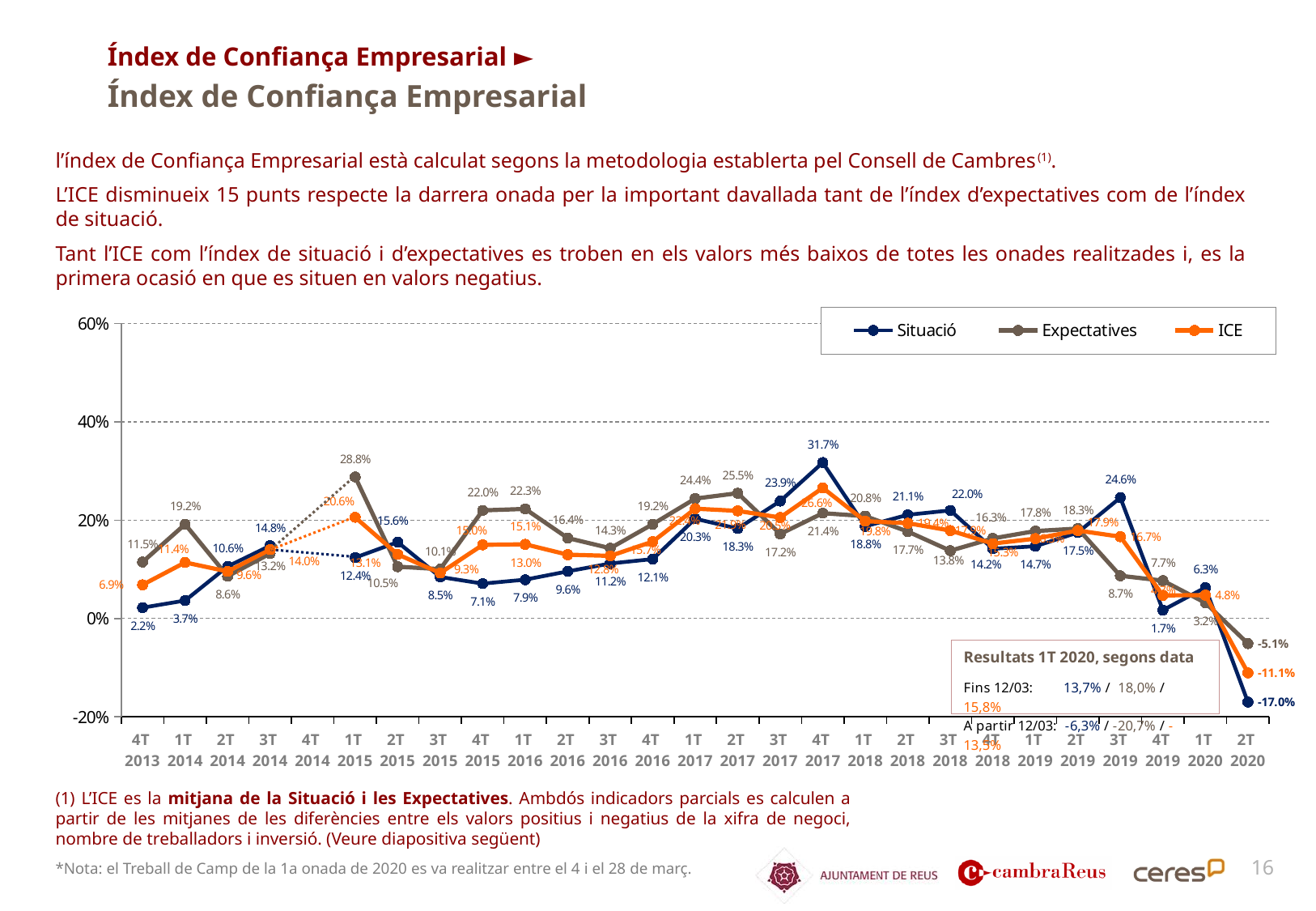
In which quarter does the Situació series reach its highest value? 4T 2017 Is the Situació value in 4T 2017 greater or less than 20%? greater How many series does the chart legend list? 3 Do the three series rise or fall between 1T 2020 and 2T 2020? fall How many quarters are labelled on the x axis? 27 What is the difference between the Situació value in 4T 2017 (31.7%) and the Expectatives value in 4T 2017 (21.4%)? 10.3 percentage points In which quarter does the Expectatives series reach its lowest value? 2T 2020 What is the value of Situació in 2T 2020? -17.0% What is the value of ICE in 2T 2020? -11.1% Which is larger in 3T 2019: Situació or Expectatives? Situació What is the value of Expectatives in 1T 2015? 28.8% What kind of chart is shown on the slide? line chart